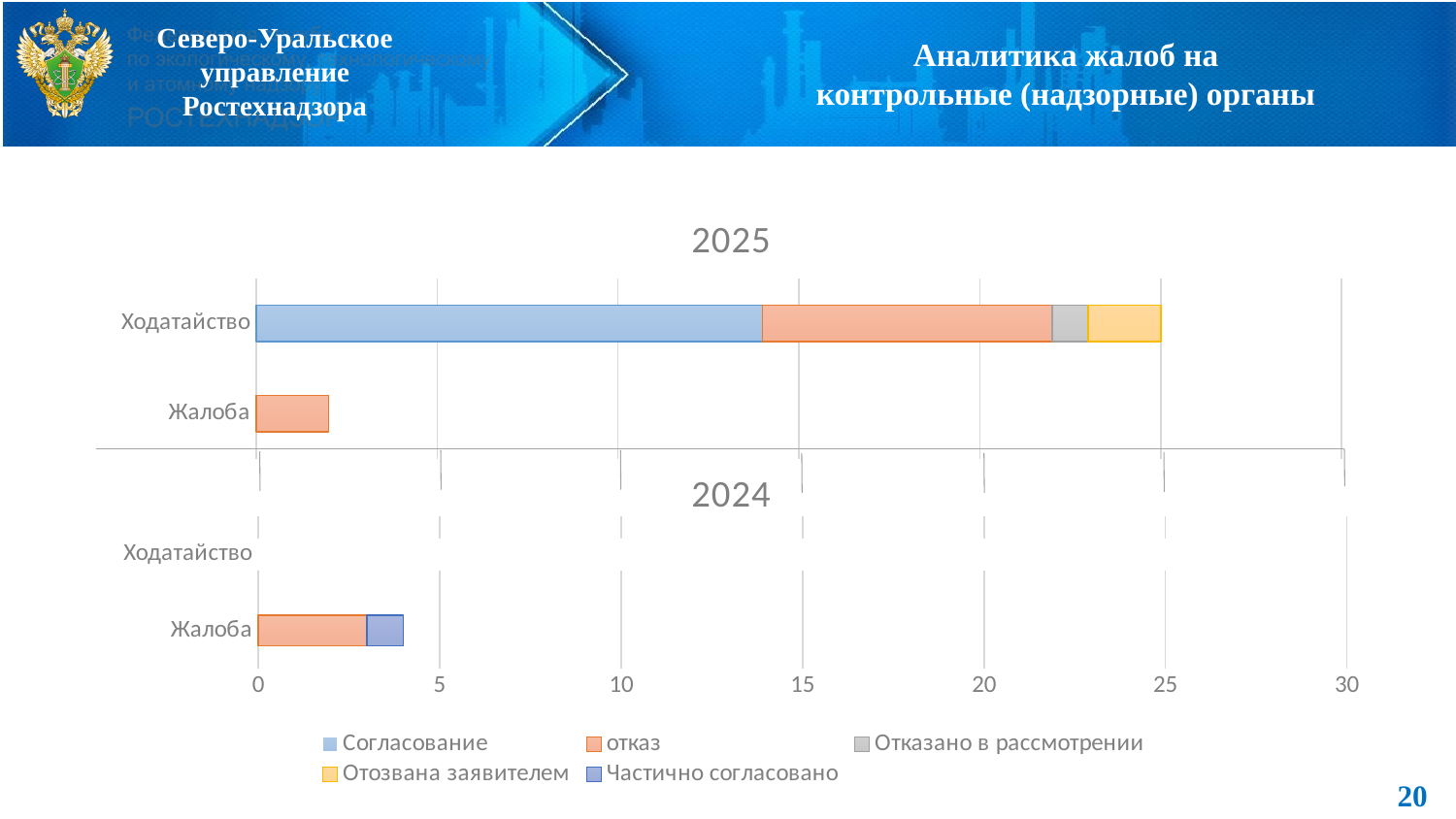
In the 2025 chart, which is larger, the bar for Ходатайство or the bar for Жалоба? Ходатайство What is the highest value shown on the x axis of the 2024 chart? 30 In the 2024 chart, which category has a visible bar? Жалоба What colour represents Согласование in the legend? blue In the 2025 chart, is the Согласование segment for Ходатайство greater or less than 10? greater In the 2025 chart, is the total value for Ходатайство greater or less than 20? greater In the 2024 chart, is the total value for Жалоба greater or less than 5? less What kind of chart is the 2025 chart? bar chart How many series does the legend list? 5 In the 2025 chart, which category has the longest bar? Ходатайство How many categories are shown in the 2025 chart? 2